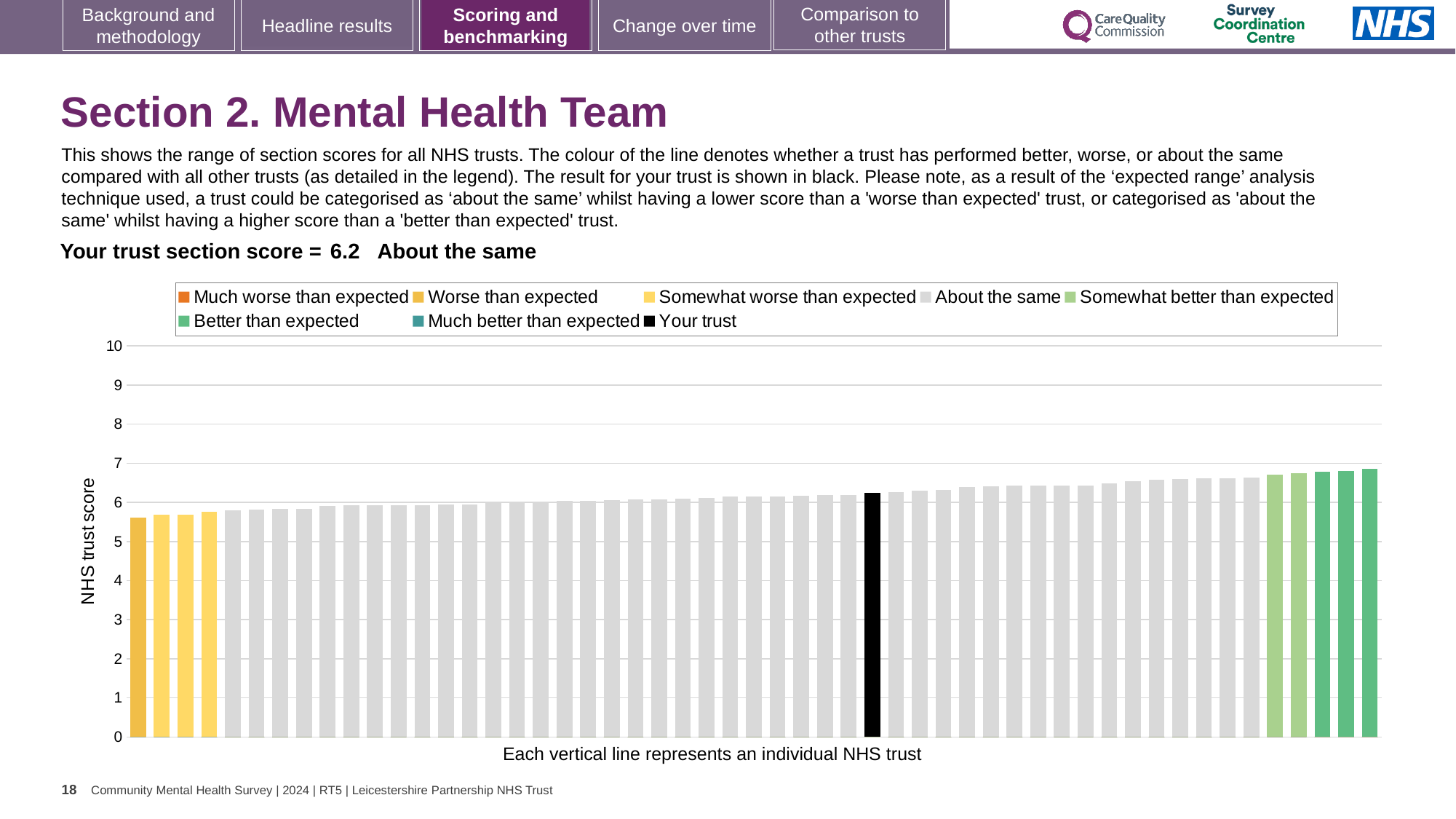
How many bars on the chart are coloured green (somewhat better or better than expected)? 5 Which performance category is your trust placed in for this section? About the same How many bars on the chart are coloured yellow (worse or somewhat worse than expected)? 4 How many entries does the chart legend list? 8 Is the value of the black 'Your trust' bar greater or less than 6? greater What is the section score for your trust shown on the slide? 6.2 What kind of chart is shown on the slide? bar chart Do the bar values rise or fall moving from left to right along the x axis? rise Is the value of the highest bar on the chart greater or less than 7? less What is the label on the vertical axis of the chart? NHS trust score What colour is the bar representing your trust? black Is the value of the lowest bar on the chart greater or less than 6? less